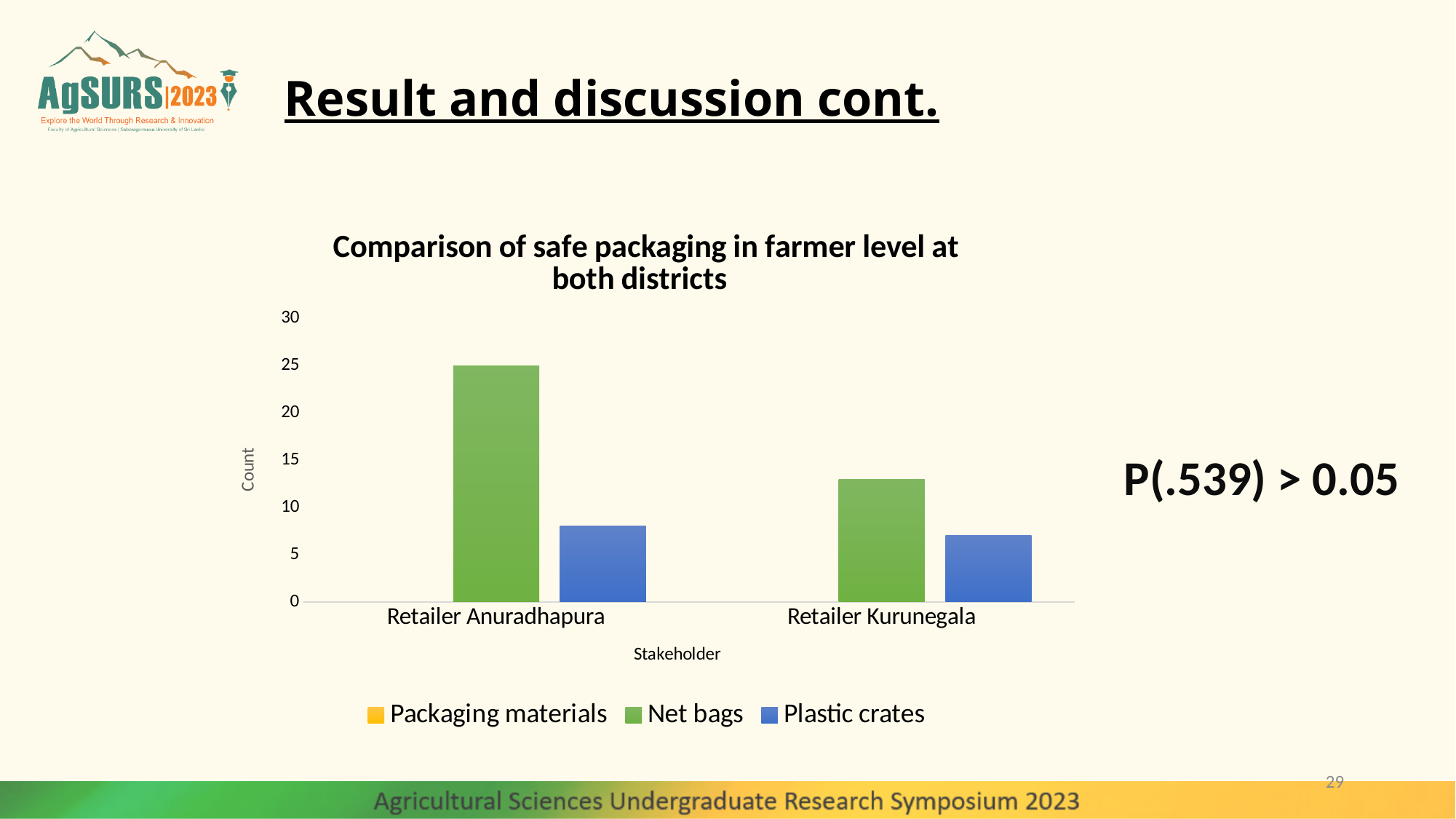
What is the label of the chart's y axis? Count How many stakeholder categories are shown on the x axis of the chart? 2 What kind of chart is shown on the slide? bar chart Is the Plastic crates value for Retailer Anuradhapura greater or less than 10? less Is the Net bags value for Retailer Kurunegala greater or less than 10? greater Which is larger for Retailer Kurunegala, Net bags or Plastic crates? Net bags How many series does the chart's legend list? 3 What is the Net bags count for Retailer Anuradhapura? 25 Which bar is the highest in the chart? Net bags for Retailer Anuradhapura Which bar is the lowest in the chart? Plastic crates for Retailer Kurunegala Is the Net bags value for Retailer Kurunegala greater or less than 15? less What is the title of the chart? Comparison of safe packaging in farmer level at both districts